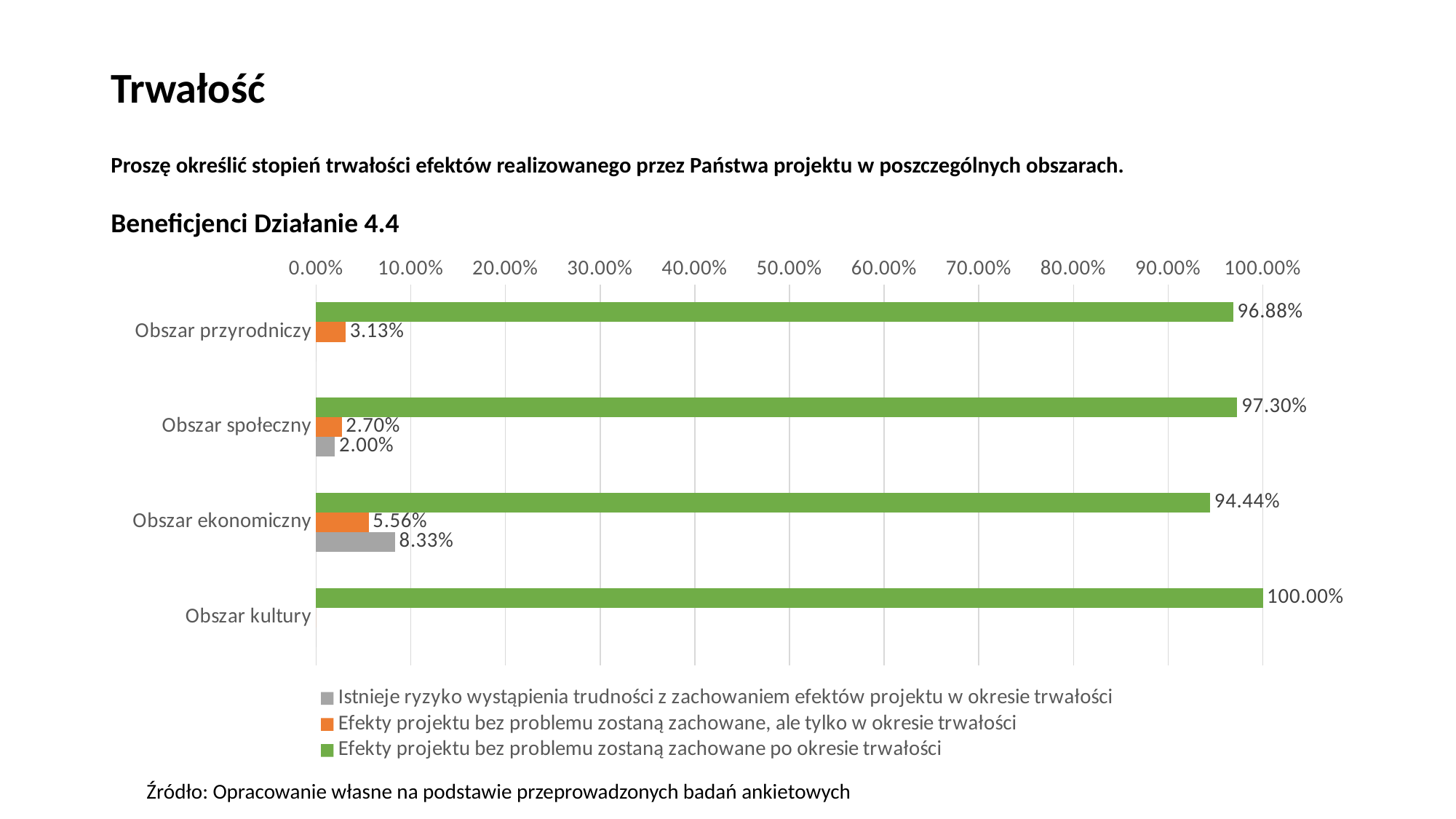
Which category has the highest value for 'Efekty projektu bez problemu zostaną zachowane po okresie trwałości'? Obszar kultury What kind of chart is shown on the slide? Bar chart Which is larger for Obszar ekonomiczny: the orange series value or the grey series value? The grey series (8.33%) What is the value of 'Istnieje ryzyko wystąpienia trudności z zachowaniem efektów projektu w okresie trwałości' for Obszar społeczny? 2.00% How many categories are shown on the y axis? 4 Which category has the lowest value for 'Efekty projektu bez problemu zostaną zachowane po okresie trwałości'? Obszar ekonomiczny What is the value of 'Efekty projektu bez problemu zostaną zachowane, ale tylko w okresie trwałości' for Obszar ekonomiczny? 5.56% What is the difference between the 'Istnieje ryzyko...' values for Obszar ekonomiczny and Obszar społeczny? 6.33% Is the green bar for Obszar ekonomiczny greater or less than 90.00%? greater How many series does the legend list? 3 What is the heading above the chart? Beneficjenci Działanie 4.4 What is the value of 'Efekty projektu bez problemu zostaną zachowane po okresie trwałości' for Obszar przyrodniczy? 96.88%